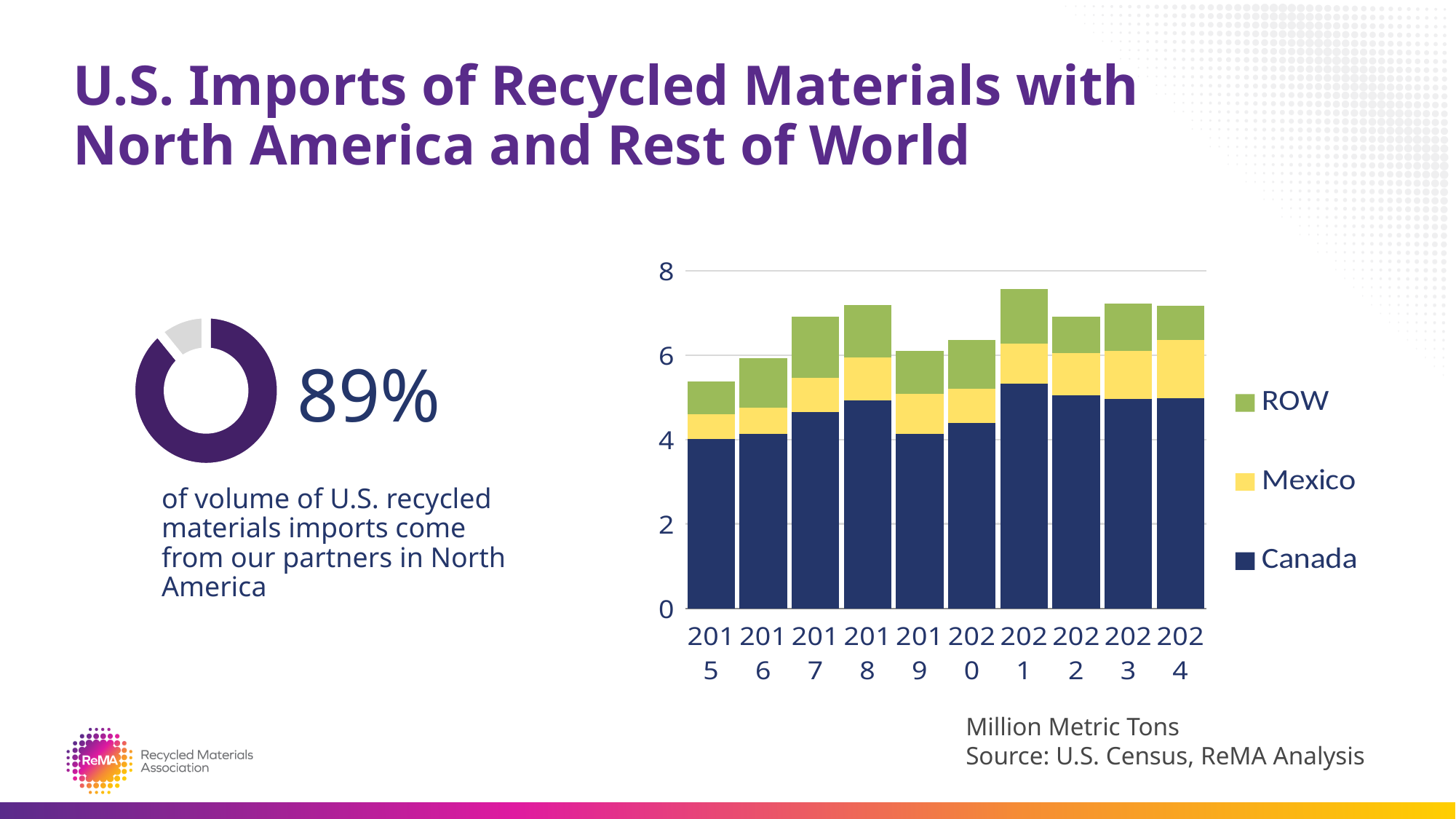
In the bar chart, is the Canada value for 2021 greater or less than 4? greater What kind of chart is the chart on the right side of the slide? Stacked bar chart How many years are shown on the x axis of the bar chart? 10 In the bar chart, is the total for 2015 greater or less than 6? less In the bar chart, is the total for 2021 greater or less than 6? greater In the bar chart, which year has the highest total imports? 2021 In the bar chart, do total imports rise or fall from 2015 to 2018? rise How many series does the legend of the bar chart list? 3 What percentage does the donut chart on the left show? 89% In the bar chart, which year has the lowest total imports? 2015 What unit is given for the values in the bar chart? Million Metric Tons In the bar chart, which year has the larger total, 2018 or 2016? 2018